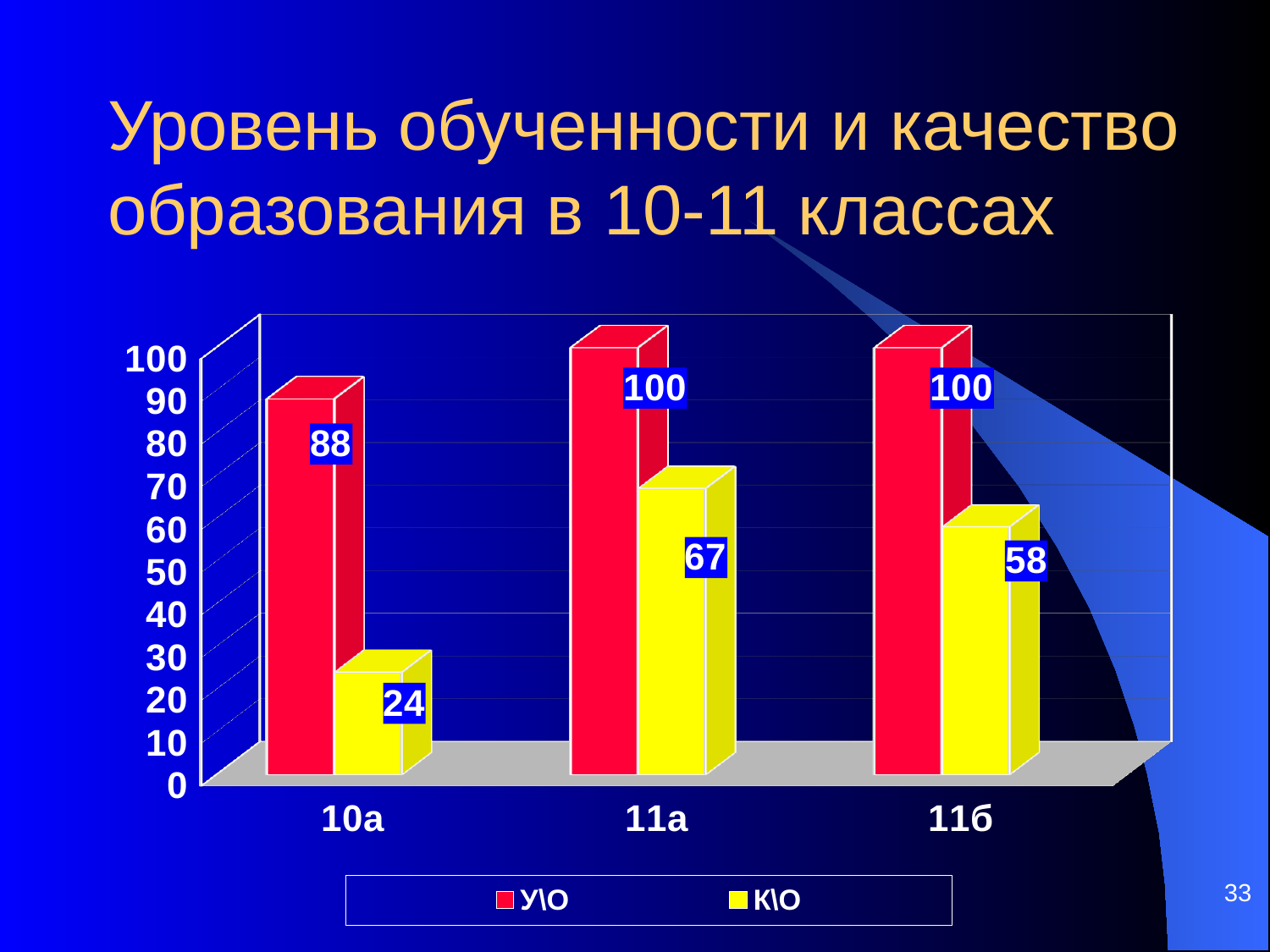
What is the У\О value for class 10а? 88 What is the К\О value for class 11б? 58 Which is larger, the К\О value for 11а or for 11б? 11а Which class has the lowest К\О value? 10а What is the К\О value for class 11а? 67 What kind of chart is shown on the slide? bar chart How many series does the legend list? 2 What is the difference between the У\О and К\О values for class 10а? 64 How many classes are shown on the x axis? 3 What is the difference between the К\О values for 11а and 11б? 9 Which class has the highest К\О value? 11а Which colour represents the К\О series? yellow